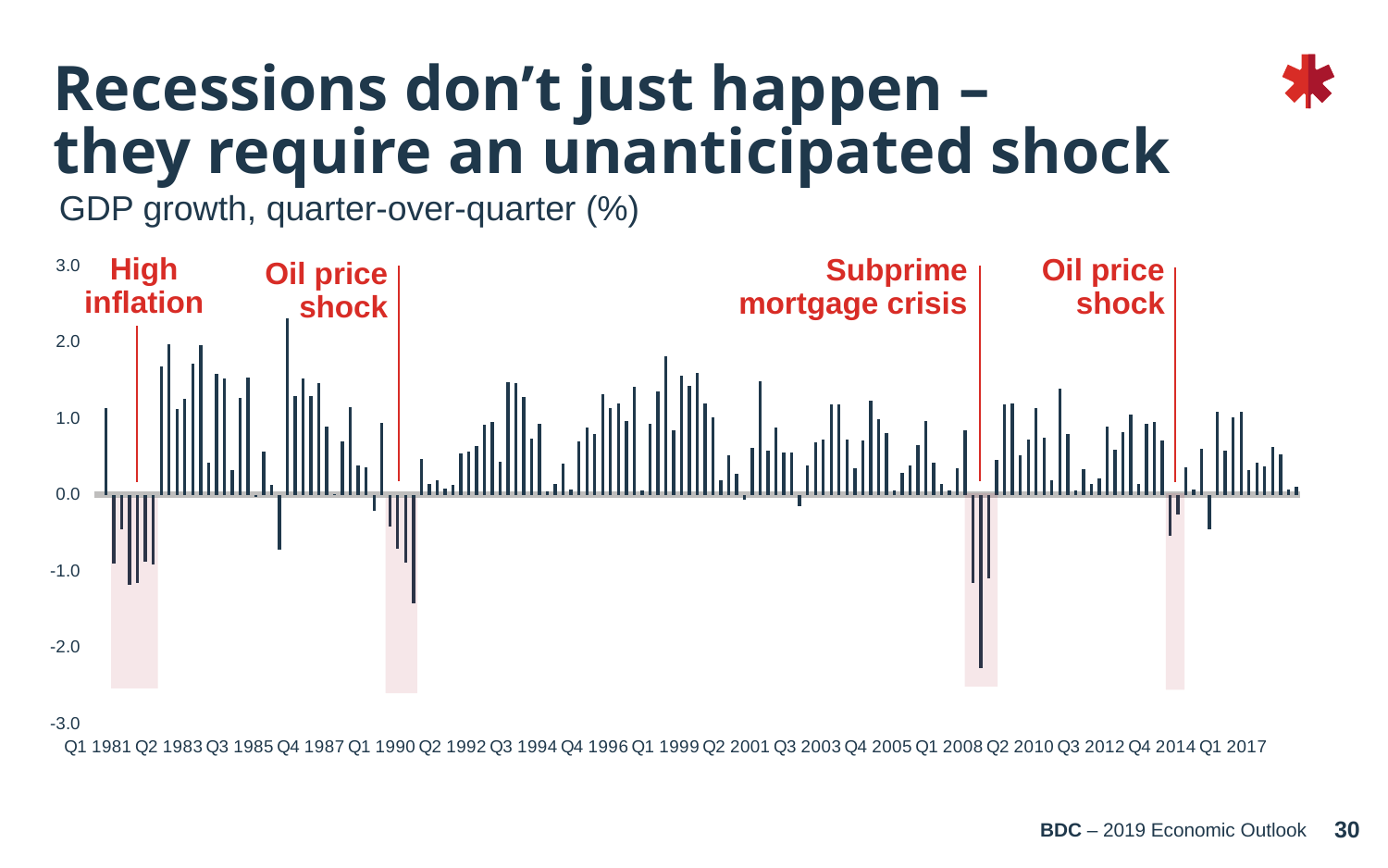
Which labelled shock is associated with the largest single-quarter decline in GDP growth? Subprime mortgage crisis What is the last quarter labelled on the horizontal axis? Q1 2017 What does the chart's subtitle say is being plotted? GDP growth, quarter-over-quarter (%) Is the tallest bar on the chart, just before the first Oil price shock, greater or less than 2.0? greater Is the lowest bar in the shaded region around 1990 greater or less than -1.0? less What is the highest value shown on the vertical axis? 3.0 What is the lowest value shown on the vertical axis? -3.0 How many shock events are labelled in red on the chart? 4 Which shock label appears twice on the chart? Oil price shock What kind of chart is shown on the slide? bar chart Is the deepest negative bar during the Subprime mortgage crisis greater or less than -2.0? less What is the first quarter labelled on the horizontal axis? Q1 1981